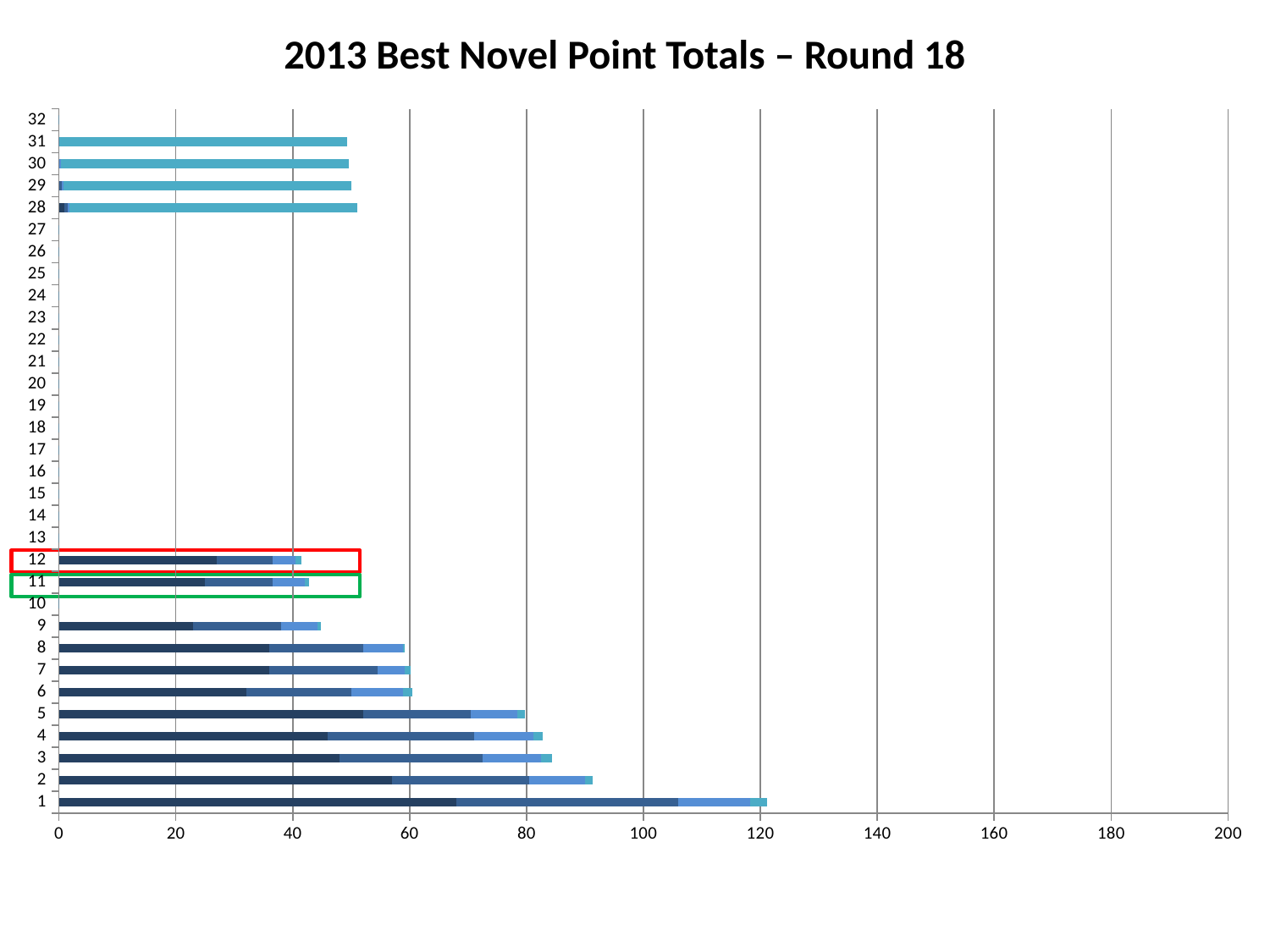
Is the total value for category 2 greater or less than 80? greater Which has the larger total value, category 5 or category 9? 5 Is the total value for category 5 greater or less than 100? less Which category's bar is outlined with a red box on the chart? 12 What is the title of the chart? 2013 Best Novel Point Totals – Round 18 What kind of chart is shown on the slide? bar chart Which category has the longest bar in the chart? 1 Which has the larger total value, category 8 or category 12? 8 Is the total value for category 12 greater or less than 60? less How many categories are labelled on the vertical axis of the chart? 32